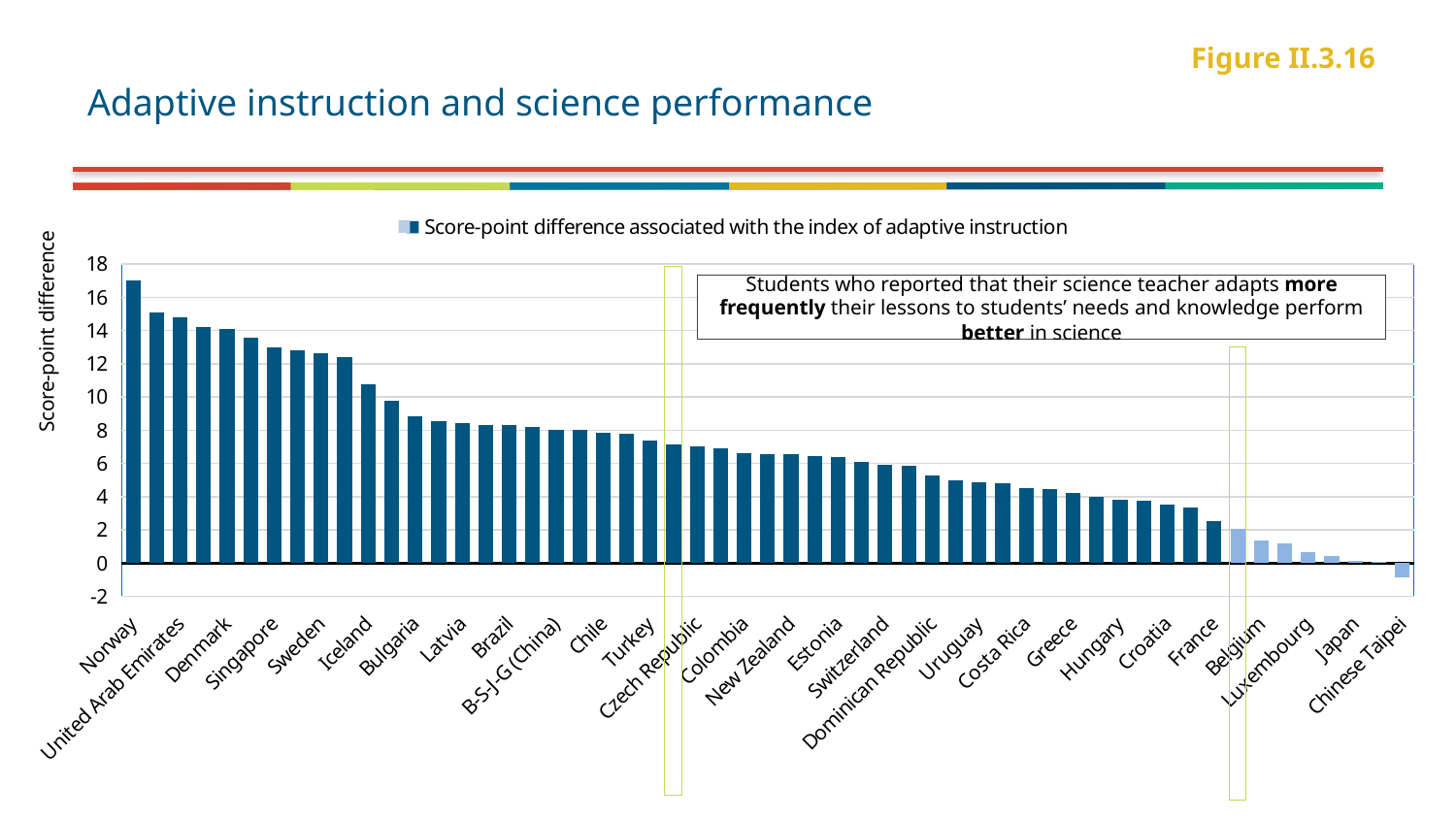
Is the value for Chile greater or less than 10? less Which has a larger score-point difference, Norway or Sweden? Norway What is the label on the vertical axis? Score-point difference Is the value for France greater or less than 4? less Which country has the lowest score-point difference? Chinese Taipei Is the value for Denmark greater or less than 12? greater Do the values rise or fall moving from left to right along the x axis? fall What kind of chart is shown on the slide? bar chart Which country has the highest score-point difference? Norway